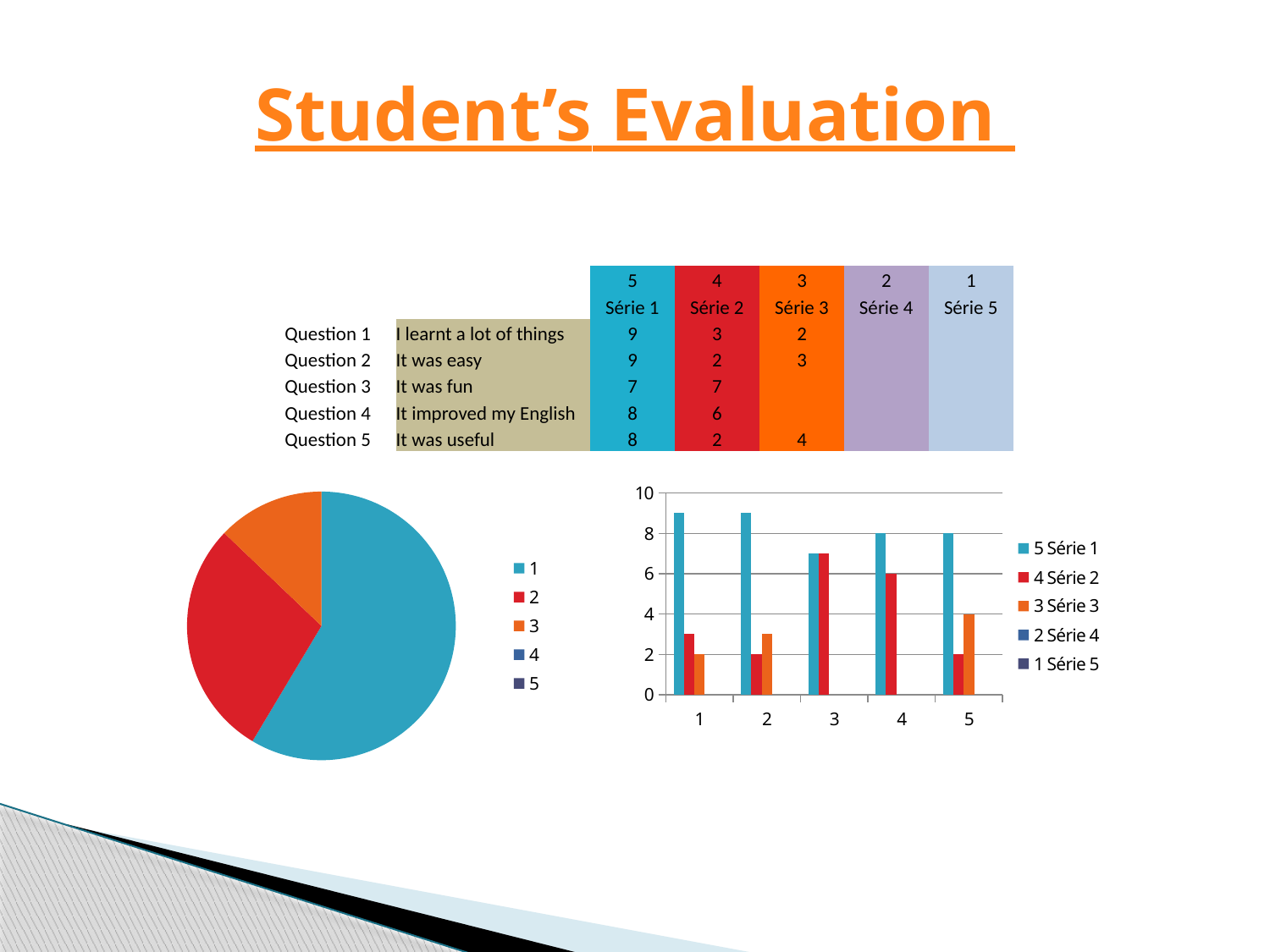
In the bar chart on the right, for category 4, which is larger: Série 1 or Série 2? Série 1 In the bar chart on the right, is the value of Série 1 for category 1 greater or less than 8? greater What kind of chart is the chart on the left of the slide? pie chart In the bar chart on the right, what is the value of Série 3 for category 5? 4 In the bar chart on the right, how many categories are shown on the x axis? 5 In the bar chart on the right, what is the difference between Série 1 and Série 2 for category 4? 2 In the bar chart on the right, for which category is Série 1 lowest? 3 In the pie chart on the left, which slice is the largest? 1 In the bar chart on the right, how many series does the legend list? 5 In the bar chart on the right, what is the value of Série 2 for category 4? 6 In the bar chart on the right, what is the value of Série 1 for category 4? 8 What kind of chart is the chart on the right of the slide? bar chart